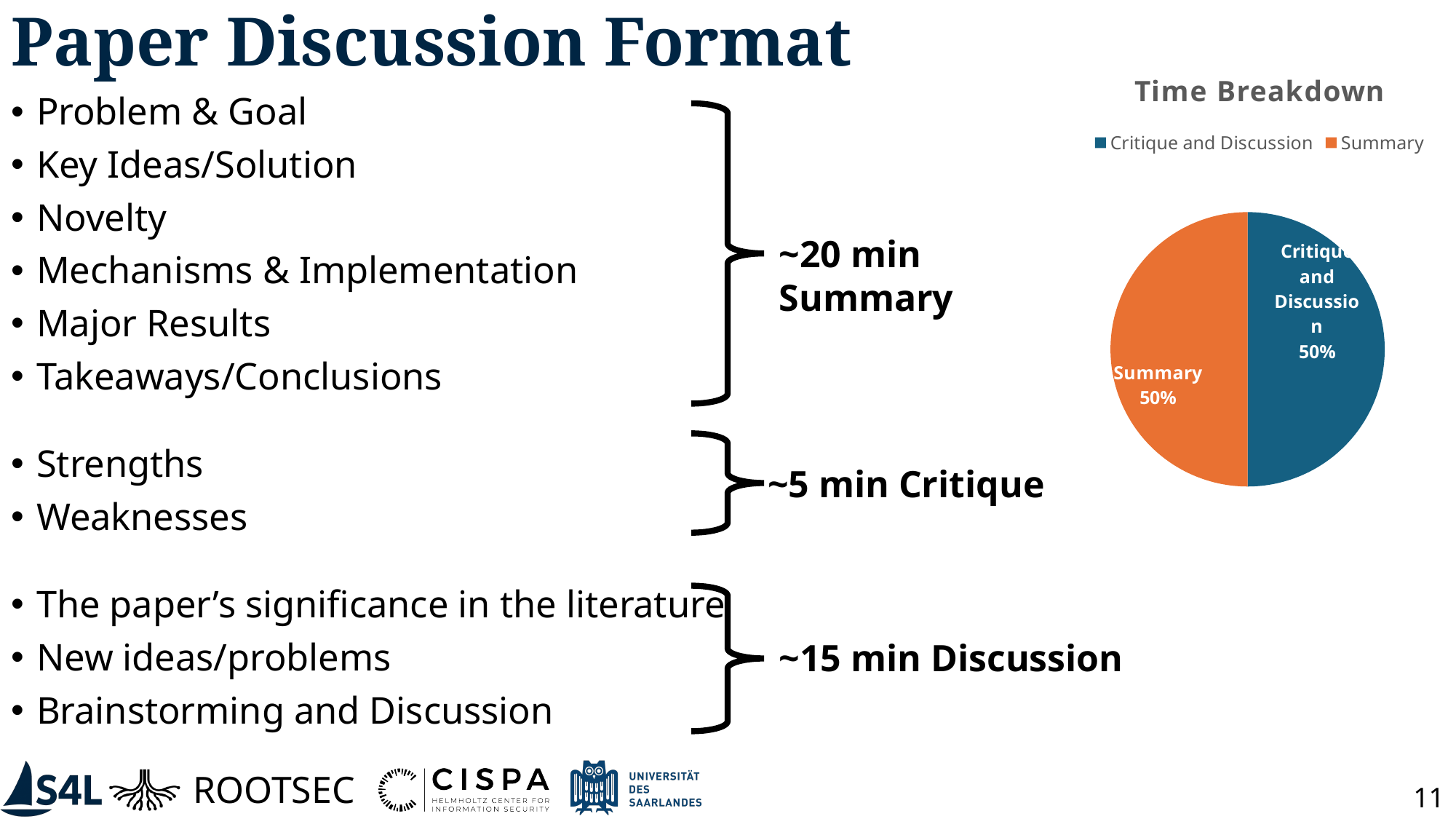
What share of the pie does the Critique and Discussion slice take? 50% What kind of chart is shown on the slide? pie chart How many entries does the chart legend list? 2 What value is labelled on the Summary slice of the pie chart? 50% What value is labelled on the Critique and Discussion slice of the pie chart? 50% What is the difference between the Summary share and the Critique and Discussion share? 0% What is the title of the chart? Time Breakdown What share of the pie does the Summary slice take? 50% Which colour is used for the Summary slice in the pie chart? orange How many slices does the pie chart have? 2